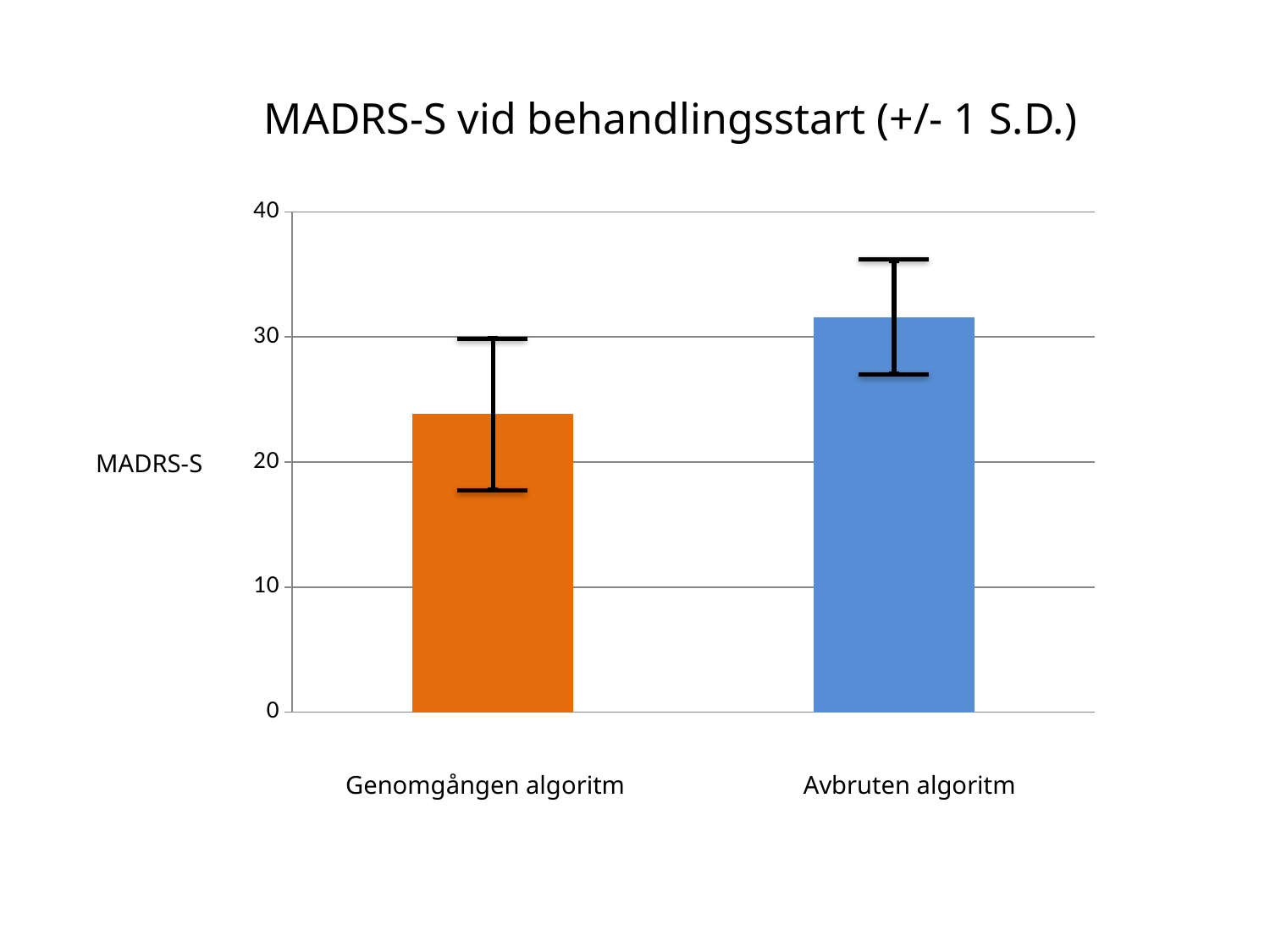
How many categories are shown on the x axis? 2 What is the title of the chart? MADRS-S vid behandlingsstart (+/- 1 S.D.) Which category has the lowest MADRS-S value? Genomgången algoritm What is the label on the y axis? MADRS-S Is the value for Avbruten algoritm greater or less than 30? greater Which category has the highest MADRS-S value? Avbruten algoritm Do the values rise or fall from Genomgången algoritm to Avbruten algoritm? rise Is the value for Avbruten algoritm greater or less than 40? less Which is larger, the value for Genomgången algoritm or the value for Avbruten algoritm? Avbruten algoritm What kind of chart is shown on the slide? bar chart Is the value for Genomgången algoritm greater or less than 30? less